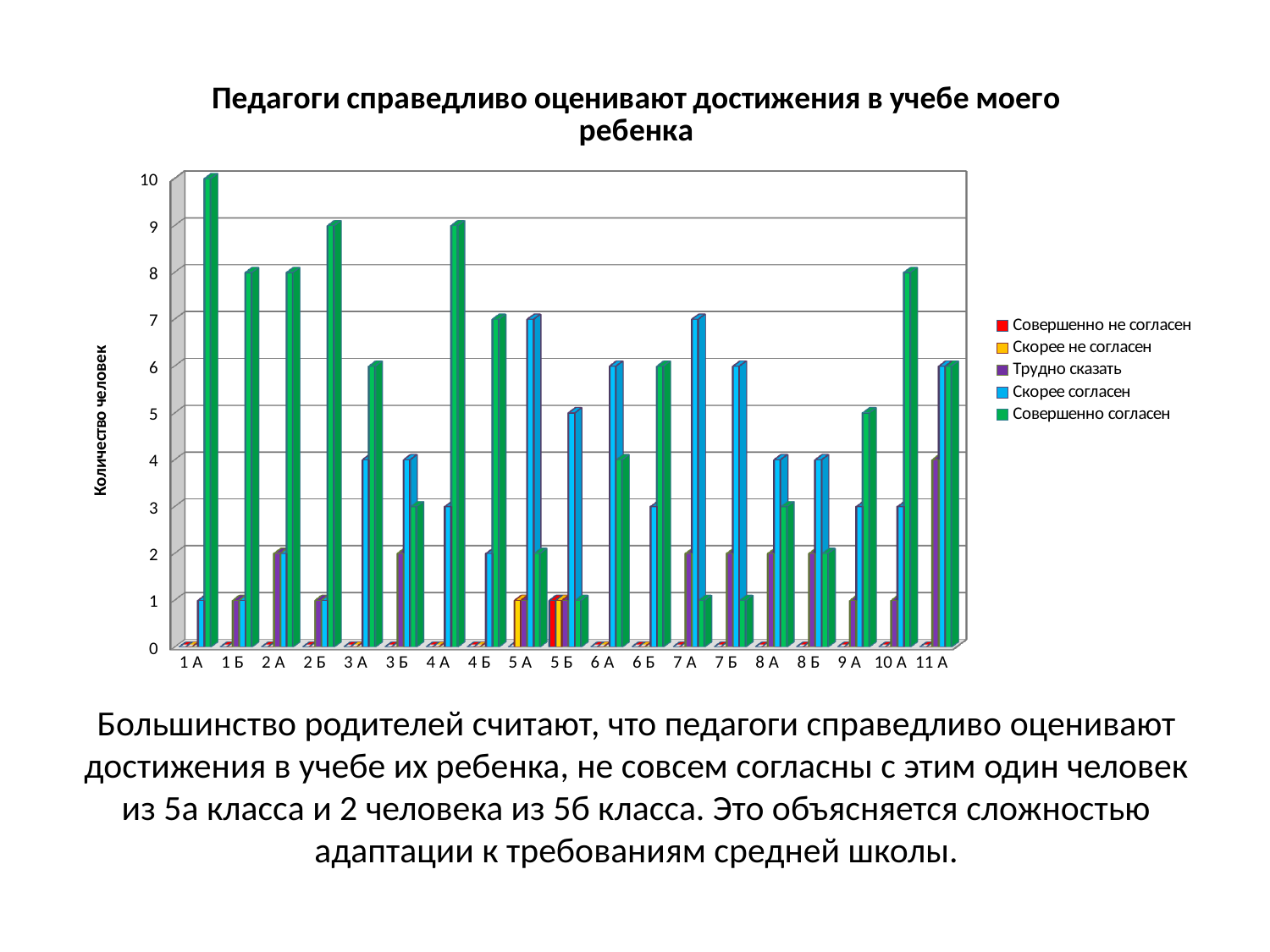
What is the label of the vertical axis? Количество человек Is the value for "Совершенно согласен" in class 3 А greater or less than 5? greater How many series does the legend list? 5 Is the value for "Скорее согласен" in class 8 А greater or less than 5? less Which class has the highest value for "Совершенно согласен"? 1 А What is the difference between the "Совершенно согласен" values for class 1 А and class 1 Б? 2 What kind of chart is shown on the slide? bar chart How many class categories are shown on the x axis? 19 What is the value for "Совершенно согласен" in class 4 А? 9 What is the value for "Совершенно согласен" in class 1 А? 10 What is the value for "Скорее согласен" in class 7 А? 7 Which is larger: "Скорее согласен" in class 7 А or in class 9 А? 7 А